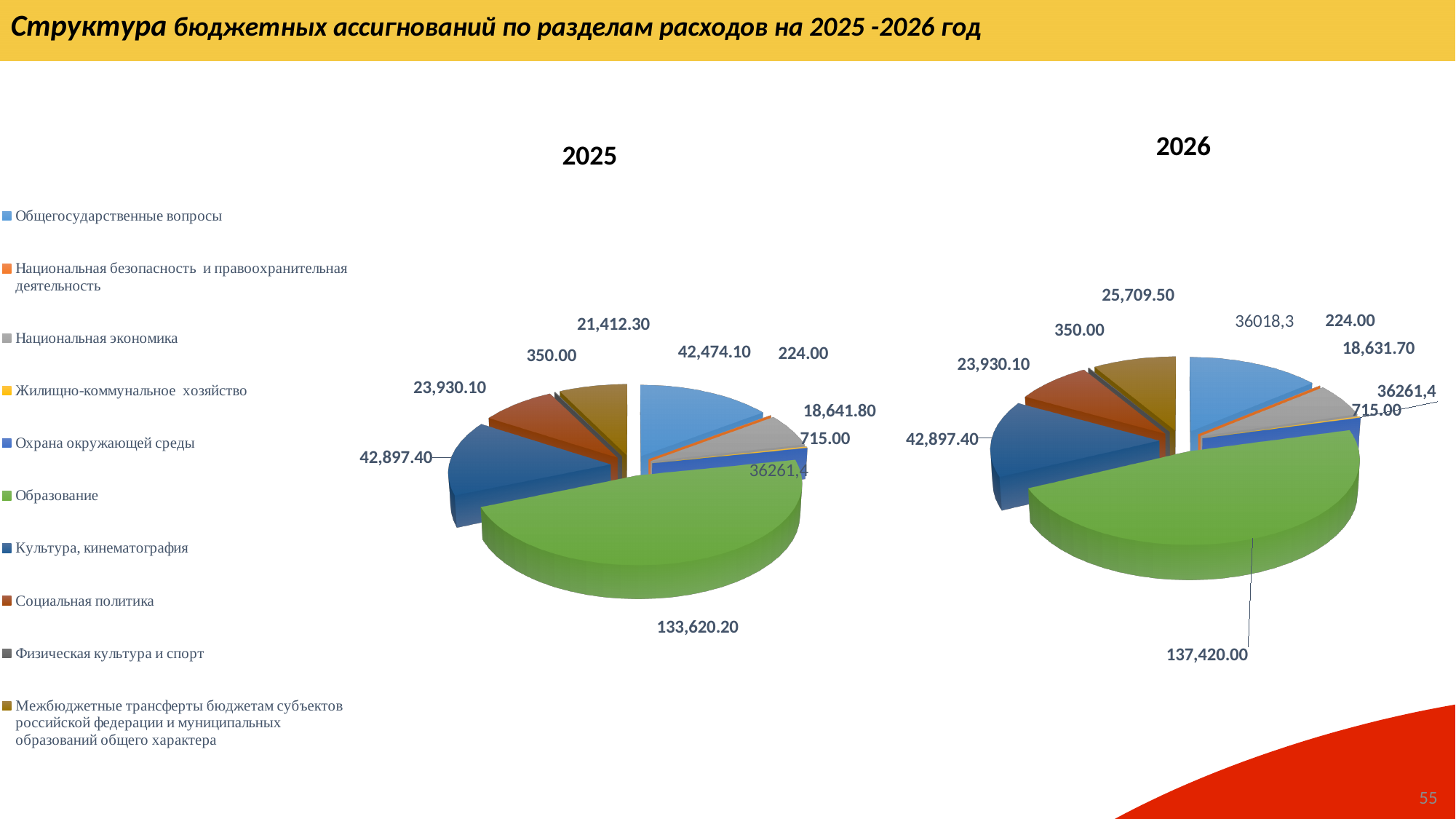
In the 2026 chart, which category has the largest slice? Образование In the 2025 chart, what is the value for Образование? 133,620.20 What are the titles of the two charts on the slide? 2025 and 2026 What kind of chart is used for the 2025 data? Pie chart Is the value for Образование larger in the 2025 chart or the 2026 chart? 2026 In the 2026 chart, what is the value for Социальная политика? 23,930.10 What is the difference between the Образование value in the 2026 chart and in the 2025 chart? 3,799.80 In the 2025 chart, which category has the largest slice? Образование In the 2025 chart, what is the value for Культура, кинематография? 42,897.40 How many categories does the legend list? 10 What colour represents Образование in the legend? Green In the 2026 chart, what is the value for Образование? 137,420.00